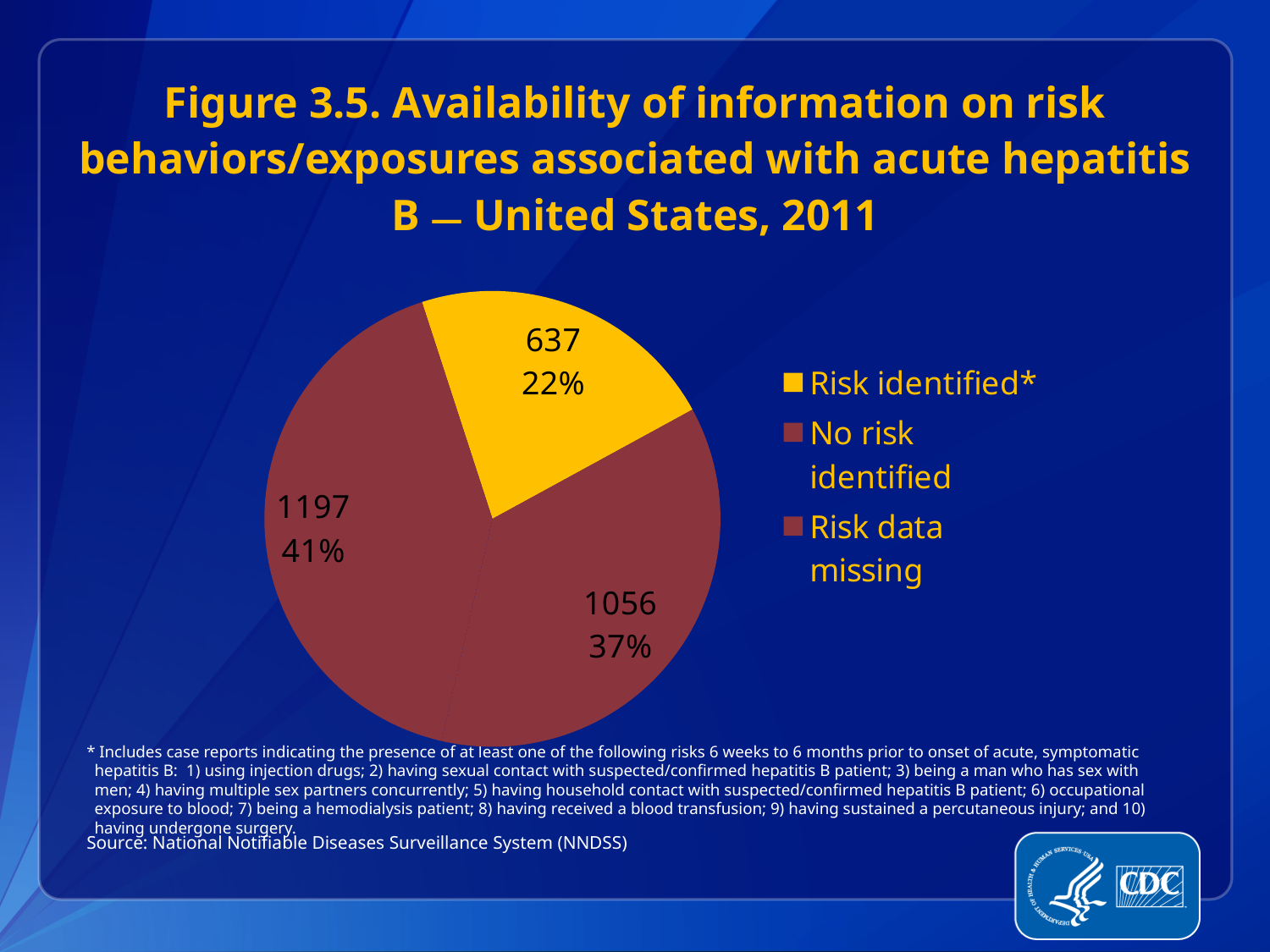
What colour is the 'Risk identified*' slice in the pie chart? yellow What share of the pie does the 'Risk identified*' slice represent? 22% What is the number of cases in the 'Risk identified*' slice? 637 What is the difference between the largest slice value (1197) and the smallest slice value (637)? 560 How many entries does the legend list? 3 What is the smallest value shown on the pie chart? 637 Which is larger: the slice labeled 1056 or the slice labeled 637? the slice labeled 1056 What is the total of the three values shown on the pie chart? 2890 What type of chart is shown on the slide? pie chart What percentage is shown for the largest slice of the pie chart? 41% How many slices does the pie chart have? 3 What is the largest value shown on the pie chart? 1197